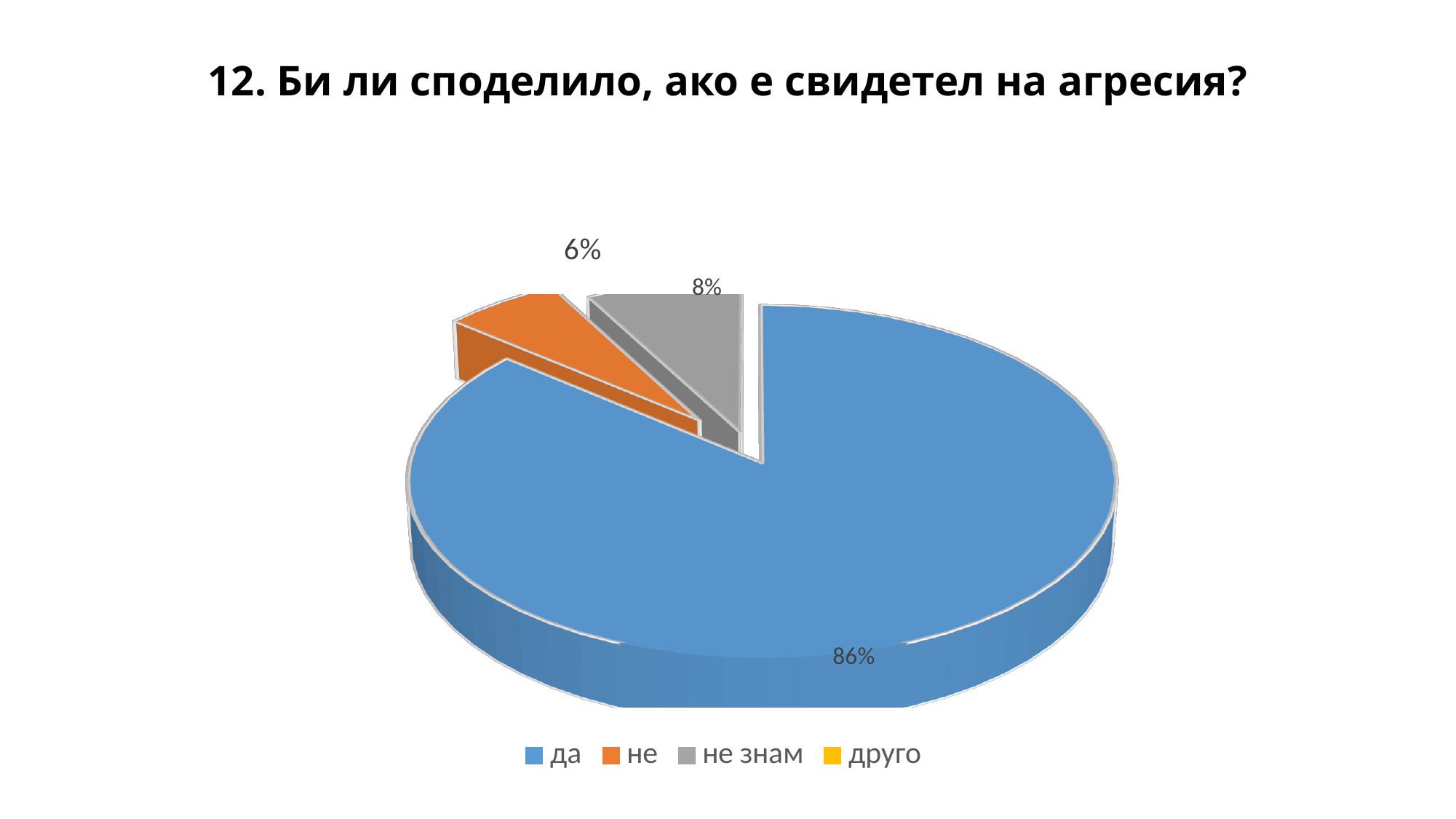
What type of chart is shown on the slide? Pie chart What is the difference in percentage points between the "да" slice and the "не знам" slice? 78 What percentage is shown for the "не" slice? 6% What percentage is shown for the "не знам" slice? 8% What is the difference in percentage points between the "не знам" slice and the "не" slice? 2 What colour represents the "да" category in the legend? Blue Which slice is larger, "не" or "не знам"? не знам What percentage of the pie chart is the "да" slice? 86% Which category has the largest share of the pie? да Of the slices with a printed percentage, which category has the smallest share? не What is the title of the chart? 12. Би ли споделило, ако е свидетел на агресия? How many categories does the legend list? 4